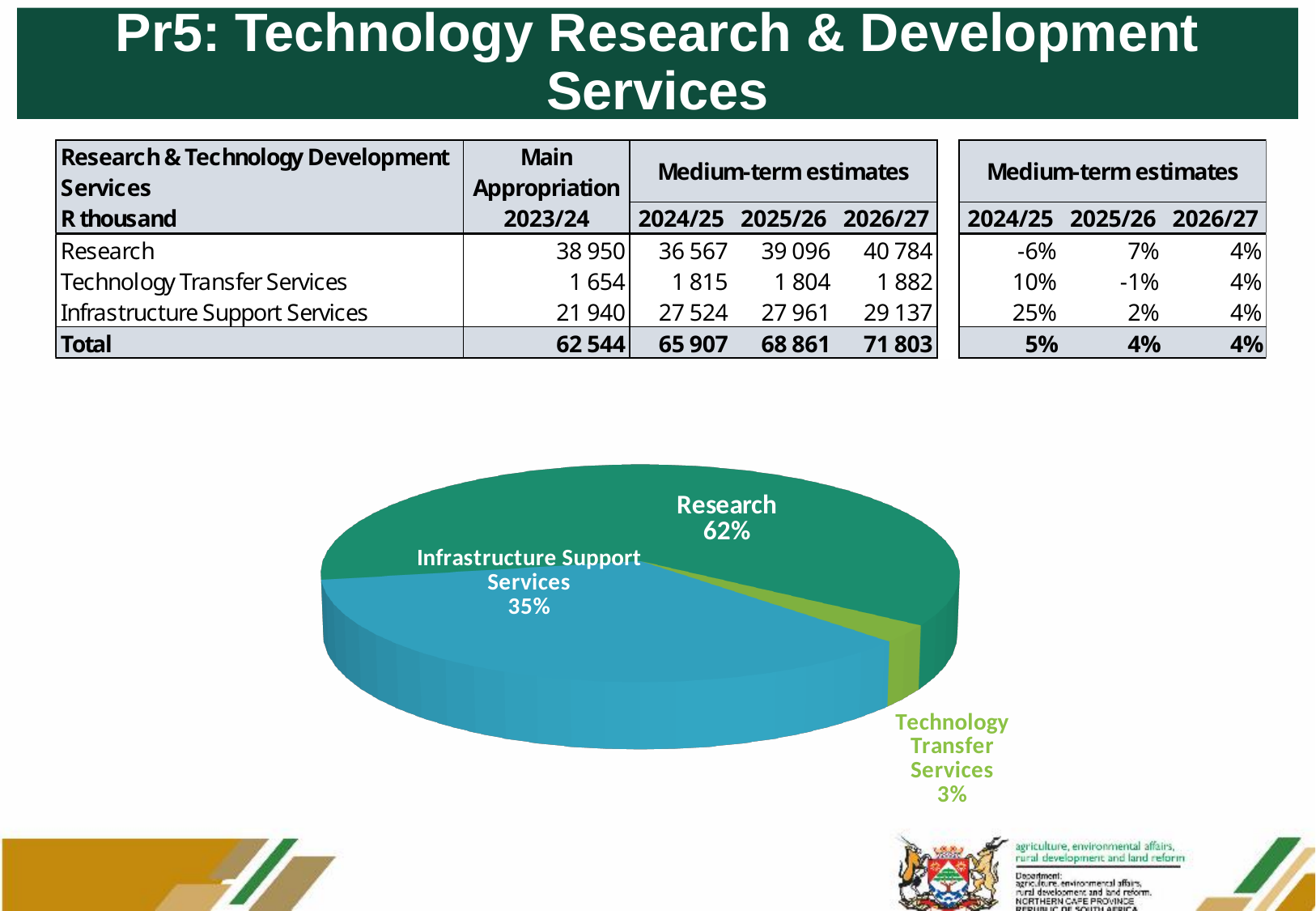
What is the difference in percentage points between the Research slice and the Infrastructure Support Services slice? 27 percentage points What share of the pie chart does Technology Transfer Services account for? 3% Which is larger in the pie chart: Infrastructure Support Services or Technology Transfer Services? Infrastructure Support Services What share of the pie chart does Infrastructure Support Services account for? 35% How many slices does the pie chart have? 3 Which slice of the pie chart is the smallest? Technology Transfer Services What colour is the Infrastructure Support Services slice in the pie chart? Blue What is the combined share of Research and Technology Transfer Services in the pie chart? 65% What share of the pie chart does Research account for? 62% Which slice of the pie chart is the largest? Research What type of chart is shown on the slide? Pie chart What colour is the Technology Transfer Services slice in the pie chart? Green